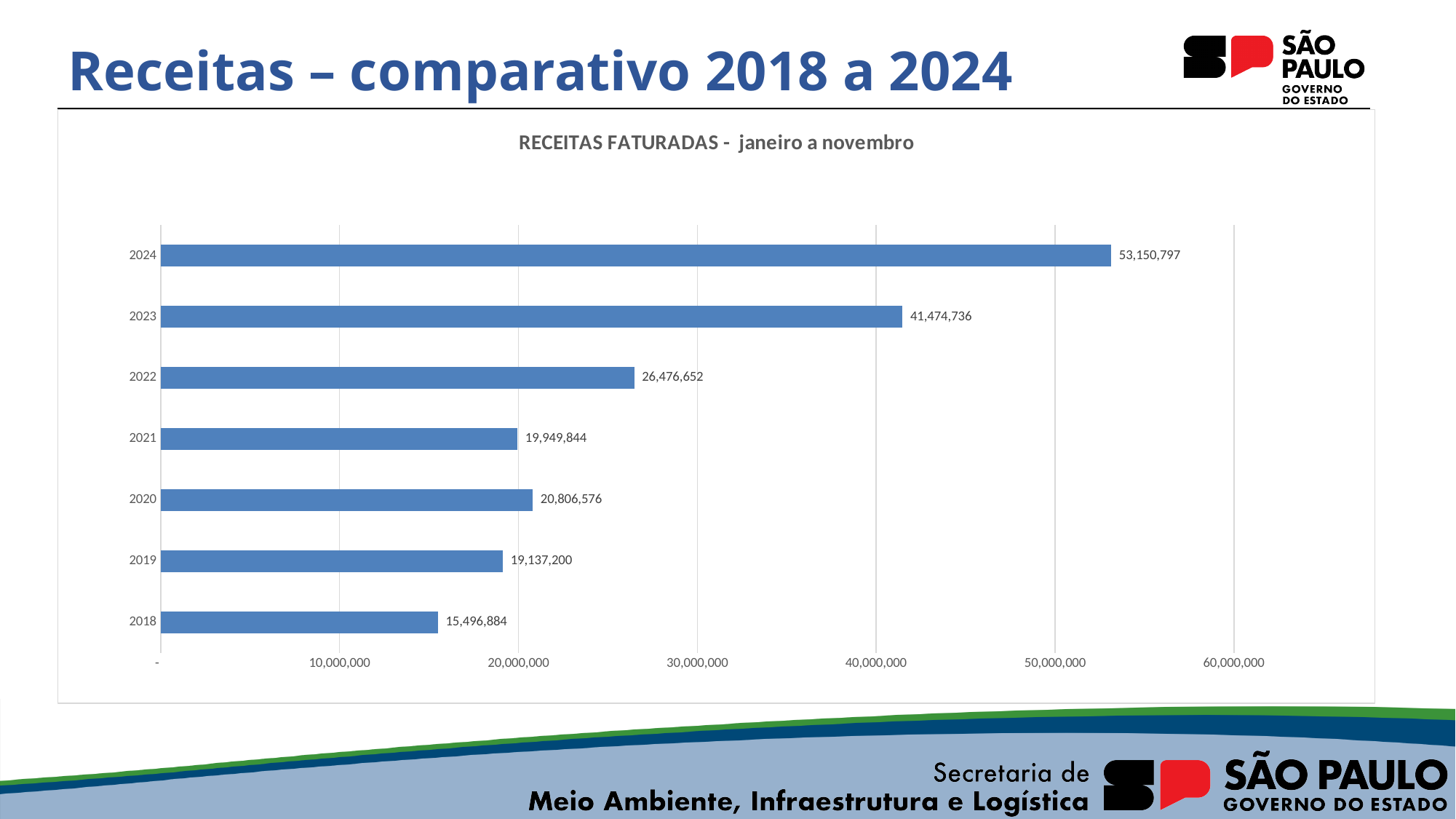
What is the value for 2021? 19,949,844 Is the value for 2022 greater or less than 30,000,000? less Which is larger, the value for 2020 or the value for 2021? 2020 What is the value for 2024? 53,150,797 Which year has the highest value? 2024 What is the value for 2018? 15,496,884 What is the difference between the values for 2020 and 2021? 856,732 Which year has the lowest value? 2018 What is the title of the chart? RECEITAS FATURADAS - janeiro a novembro How many years are shown in the chart? 7 What is the difference between the values for 2024 and 2023? 11,676,061 What kind of chart is shown on the slide? bar chart